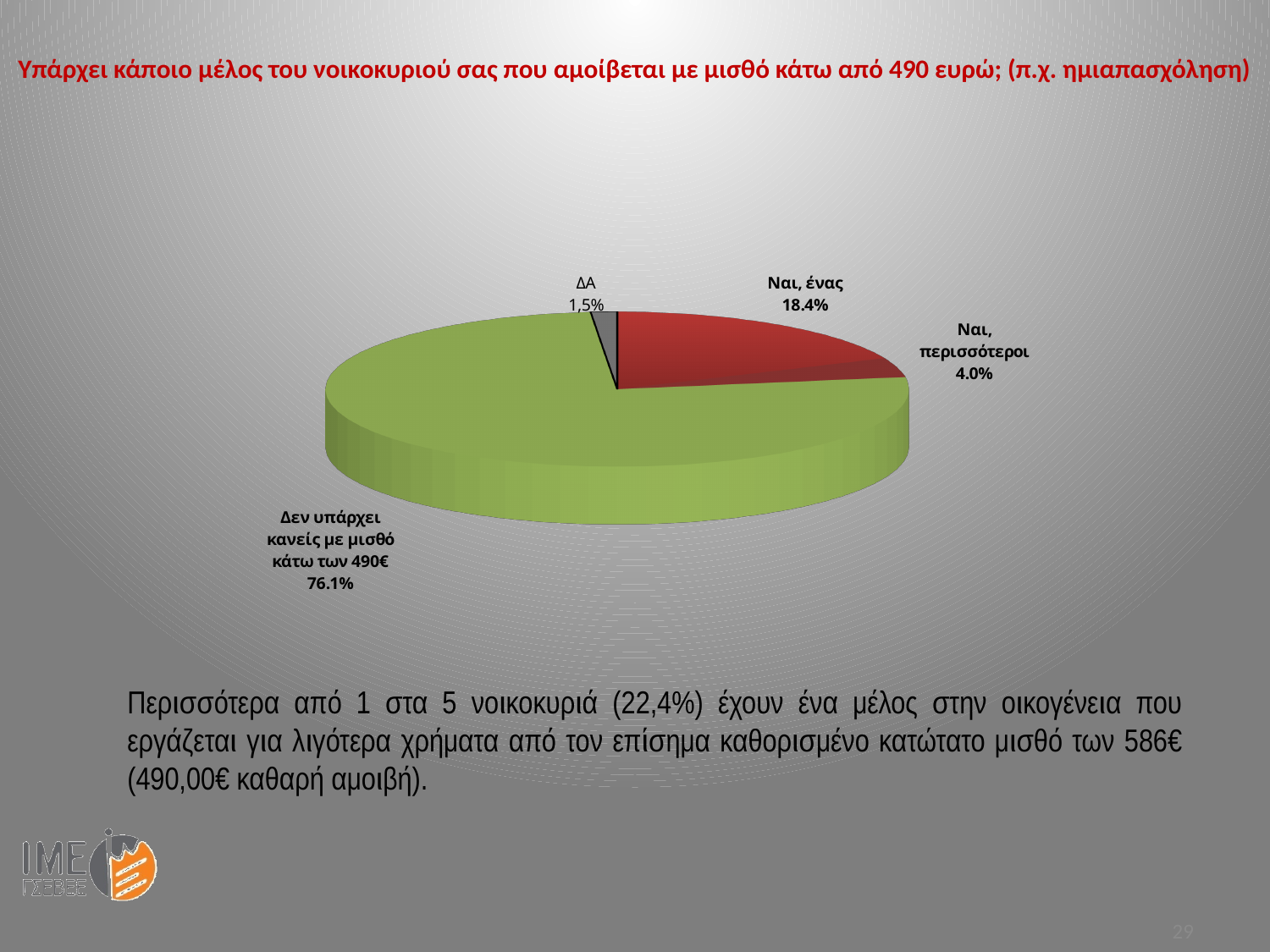
What percentage is shown for the "ΔΑ" slice? 1,5% What share of the pie is labelled "Δεν υπάρχει κανείς με μισθό κάτω των 490€"? 76.1% Which slice of the pie is the largest? Δεν υπάρχει κανείς με μισθό κάτω των 490€ Which is larger, the "Ναι, ένας" slice or the "Ναι, περισσότεροι" slice? Ναι, ένας What percentage is shown for the "Ναι, περισσότεροι" slice? 4.0% Which slice of the pie is the smallest? ΔΑ What is the difference in percentage points between the largest slice and the "Ναι, ένας" slice? 57.7 What is the difference in percentage points between the "Ναι, ένας" slice and the "Ναι, περισσότεροι" slice? 14.4 How many slices does the pie chart have? 4 What colour is the "Ναι, ένας" slice of the pie? Red What kind of chart is shown on the slide? Pie chart What percentage is shown for the "Ναι, ένας" slice? 18.4%